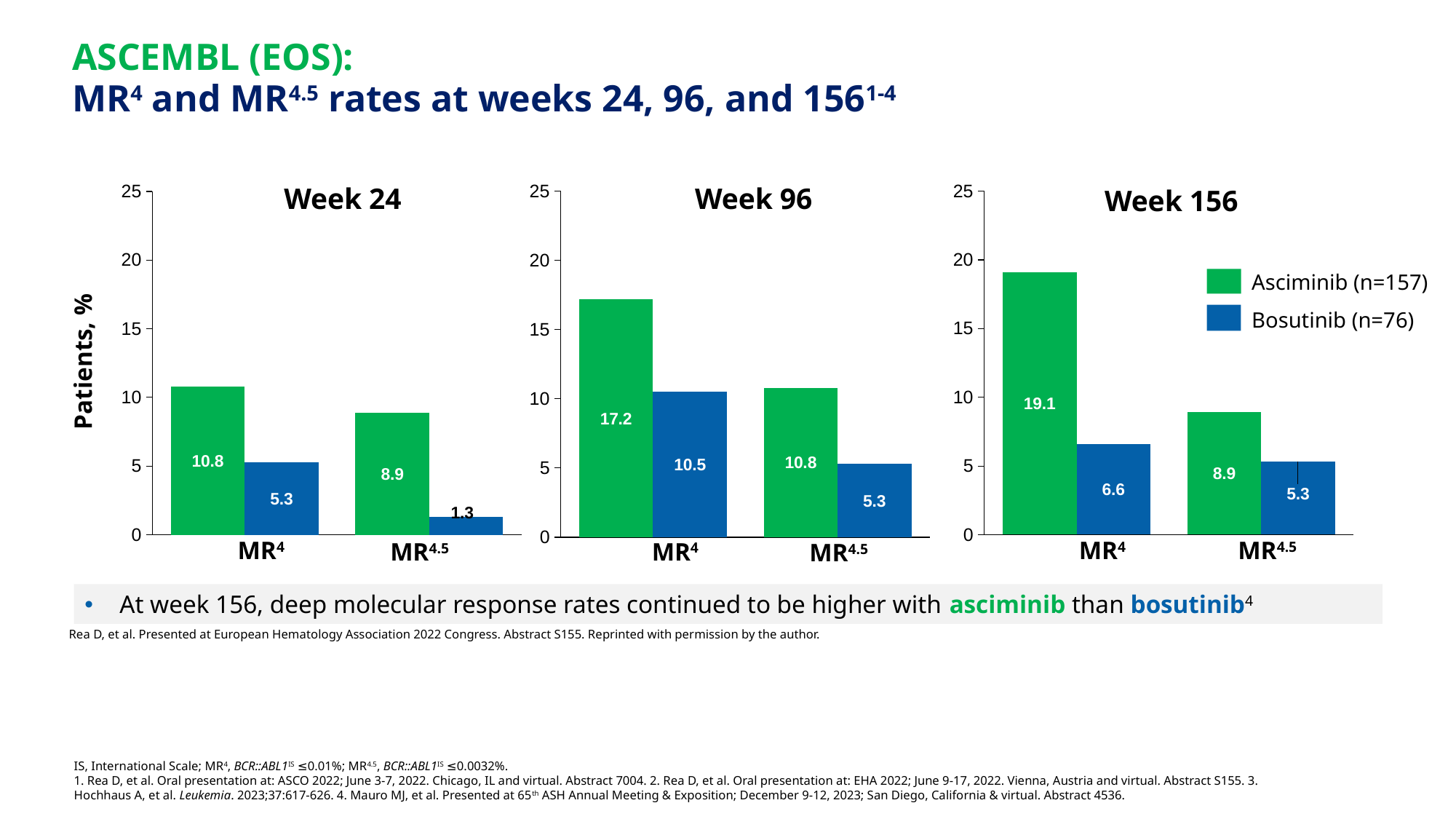
In the Week 24 chart, which treatment has the higher MR4.5 rate? Asciminib In the Week 24 chart, what is the MR4.5 rate for bosutinib? 1.3 In the Week 156 chart, what is the MR4 rate for asciminib? 19.1 In the Week 156 chart, which bar is the lowest? Bosutinib MR4.5 What is the y-axis label of the charts? Patients, % How many series does the legend list? 2 In the Week 96 chart, what is the MR4 rate for bosutinib? 10.5 In the Week 96 chart, what is the difference between the asciminib and bosutinib MR4.5 rates? 5.5 In the Week 156 chart, is the asciminib MR4 rate greater or less than 15? greater In the Week 24 chart, what is the MR4 rate for asciminib? 10.8 In the Week 156 chart, what is the difference between the asciminib and bosutinib MR4 rates? 12.5 What kind of chart is the Week 96 chart? Bar chart